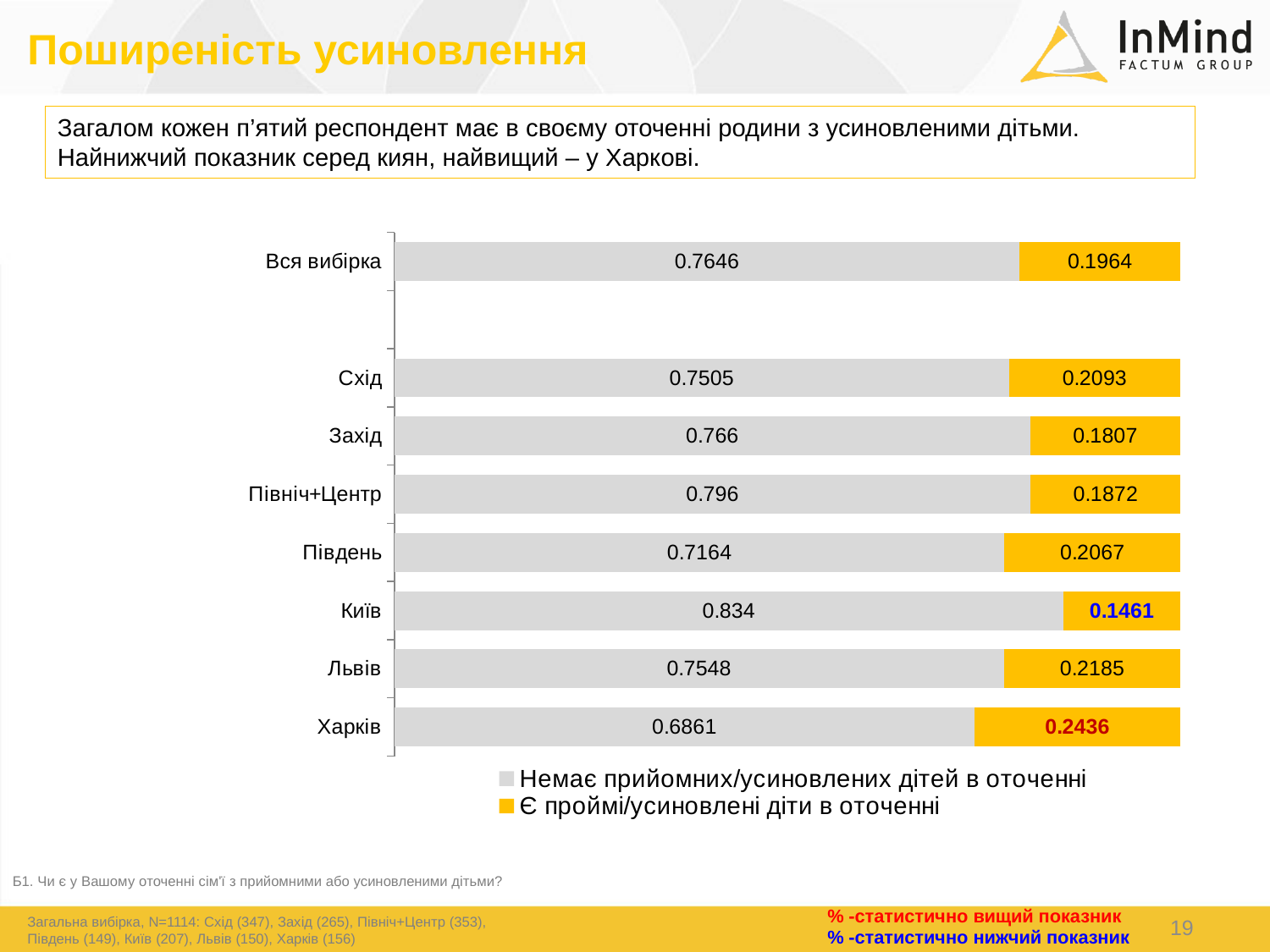
Which category has the highest value in the series "Є проймі/усиновлені діти в оточенні"? Харків What is the value for Вся вибірка in the series "Є проймі/усиновлені діти в оточенні"? 0.1964 What kind of chart is shown on the slide? Stacked bar chart What is the value for Харків in the series "Є проймі/усиновлені діти в оточенні"? 0.2436 Which category has the lowest value in the series "Є проймі/усиновлені діти в оточенні"? Київ How many categories are shown on the chart? 8 What colour represents the series "Є проймі/усиновлені діти в оточенні"? Yellow What is the value for Київ in the series "Немає прийомних/усиновлених дітей в оточенні"? 0.834 Which is larger in the series "Є проймі/усиновлені діти в оточенні": Львів or Південь? Львів How many series does the legend list? 2 What is the total of the stacked bar for Київ? 0.9801 What is the difference between Харків and Київ in the series "Є проймі/усиновлені діти в оточенні"? 0.0975